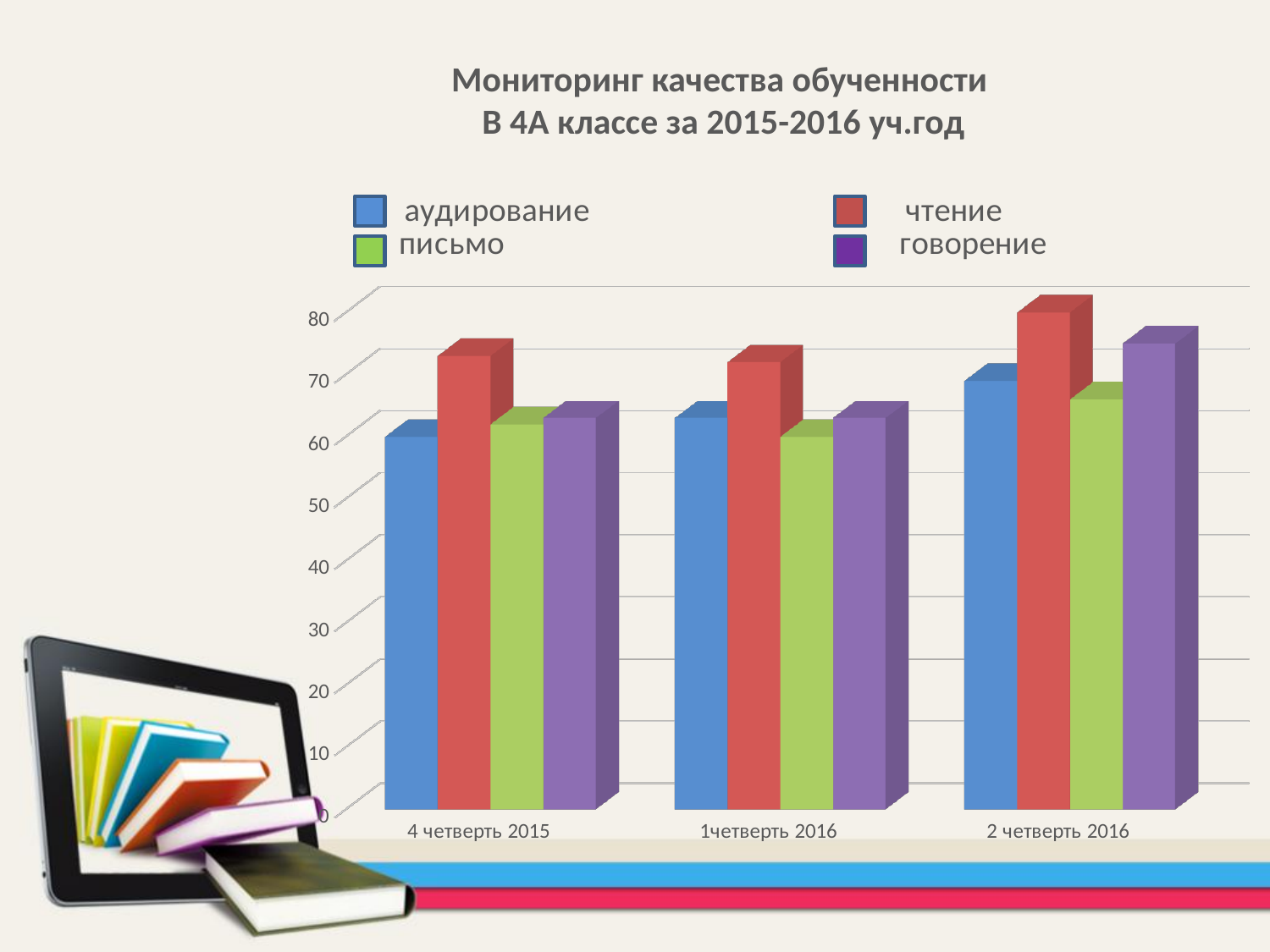
Which series has the highest value in 1четверть 2016? чтение Is the value for говорение in 2 четверть 2016 greater or less than 70? greater Which series has the highest value in 4 четверть 2015? чтение Which is larger in 2 четверть 2016: говорение or аудирование? говорение How many categories are shown on the x axis? 3 Is the value for аудирование in 4 четверть 2015 greater or less than 70? less How many series does the legend list? 4 Which series has the highest value in 2 четверть 2016? чтение Is the value for чтение in 2 четверть 2016 greater or less than 70? greater Which colour represents письмо in the legend? green Which is larger for говорение: 4 четверть 2015 or 2 четверть 2016? 2 четверть 2016 What kind of chart is shown on the slide? bar chart